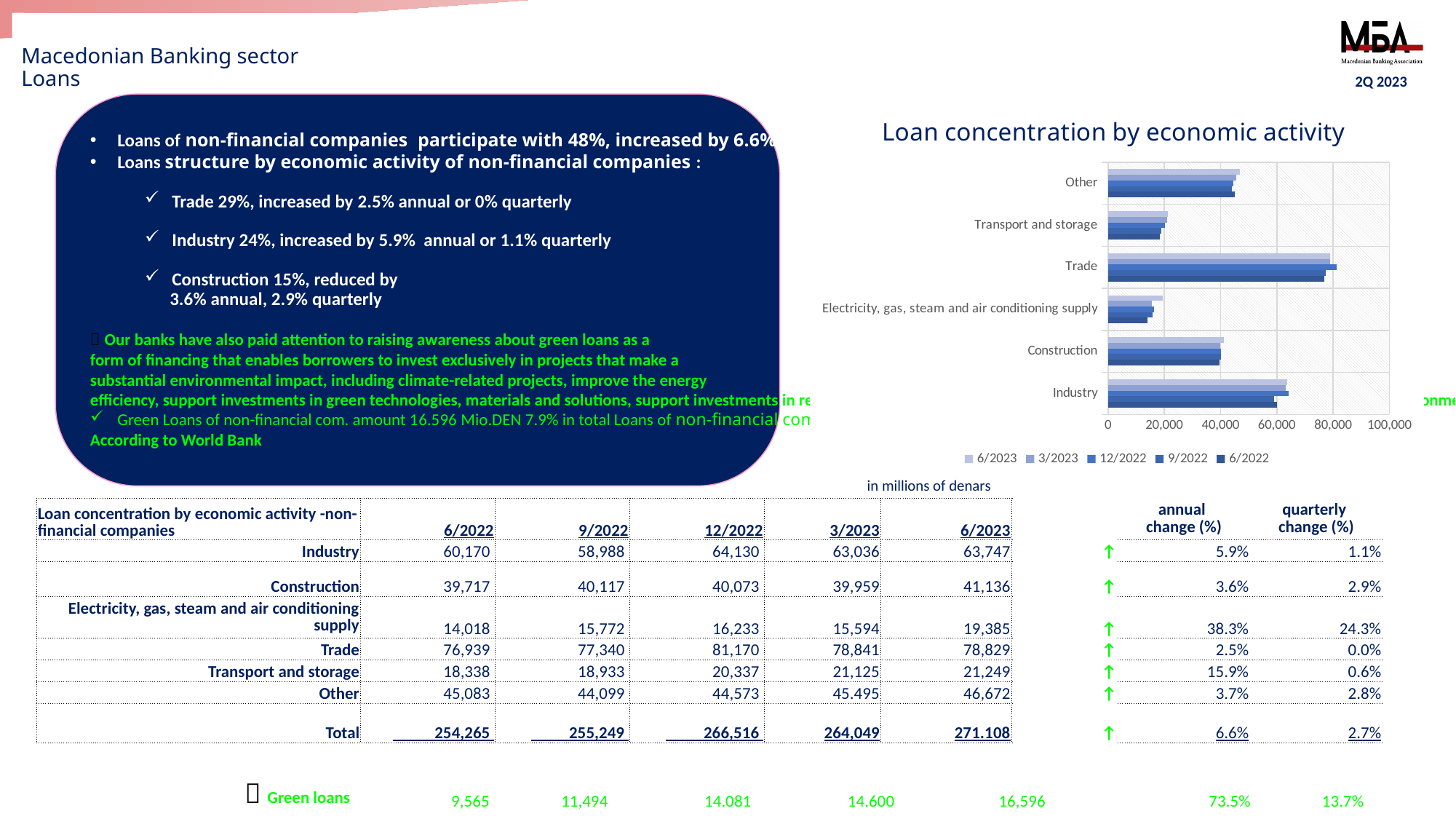
What is the highest tick value shown on the horizontal axis of the "Loan concentration by economic activity" chart? 100,000 Which economic activity has the highest loan values in the "Loan concentration by economic activity" chart? Trade In the "Loan concentration by economic activity" chart, is the value for Trade greater or less than 60,000? greater What kind of chart is shown under the title "Loan concentration by economic activity"? bar chart Which economic activity has the lowest loan values in the "Loan concentration by economic activity" chart? Electricity, gas, steam and air conditioning supply According to the table on the slide, what is the loan value for Trade in 6/2023? 78,829 According to the table on the slide, what is the loan value for Industry in 6/2022? 60,170 How many series does the legend of the "Loan concentration by economic activity" chart list? 5 In the "Loan concentration by economic activity" chart, which has larger loan values, Industry or Construction? Industry Using the table values, what is the difference between Industry and Construction loans in 6/2023? 22,611 In the "Loan concentration by economic activity" chart, is the value for Transport and storage greater or less than 40,000? less How many economic activity categories are plotted in the "Loan concentration by economic activity" chart? 6